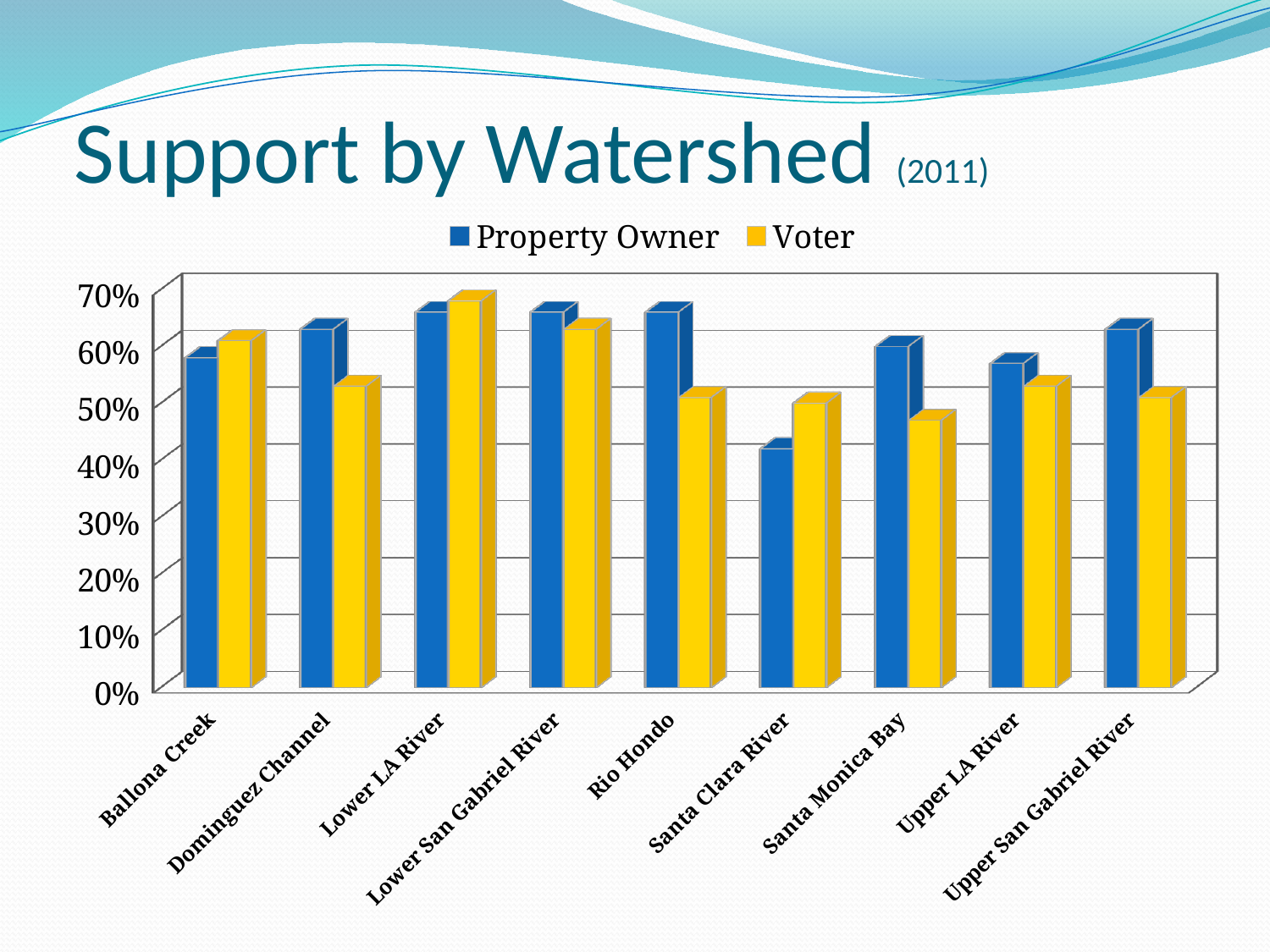
Is the Voter value for Lower LA River greater or less than 60%? greater How many watersheds are shown on the x axis of the chart? 9 Is the Property Owner value for Santa Clara River greater or less than 50%? less Which watershed has the highest Voter support? Lower LA River For Santa Clara River, which is larger: Property Owner support or Voter support? Voter What kind of chart is shown on the slide? Bar chart Which two series are listed in the chart legend? Property Owner and Voter What year is shown in the chart title? 2011 Which watershed has the lowest Property Owner support? Santa Clara River Is the Property Owner value for Rio Hondo greater or less than 60%? greater For Rio Hondo, which is larger: Property Owner support or Voter support? Property Owner How many series does the legend list? 2